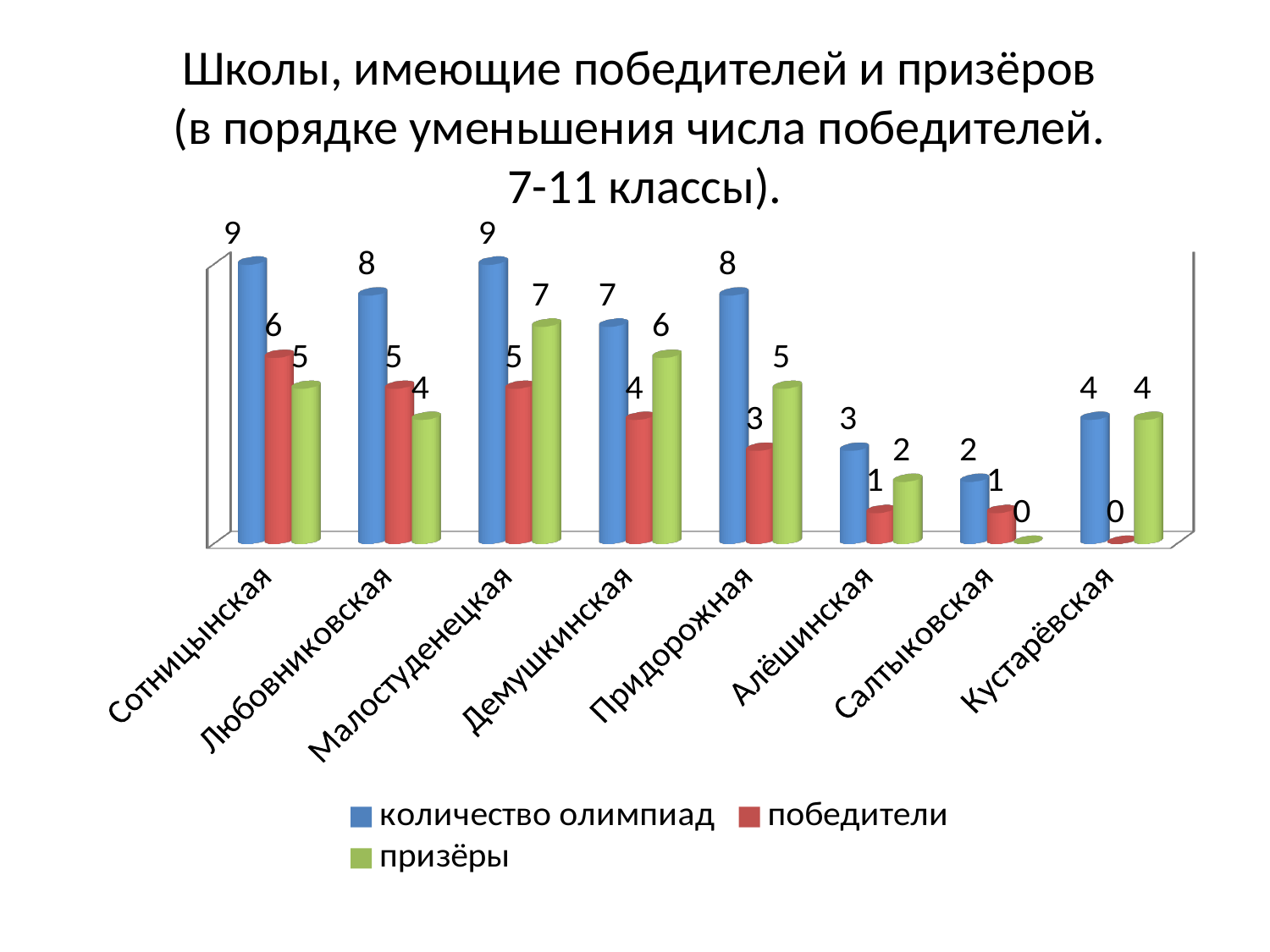
What is the difference between количество олимпиад and победители for Придорожная? 5 What is the value of призёры for Малостуденецкая? 7 What is the value of победители for Сотницынская? 6 Which is larger for Демушкинская: победители or призёры? призёры Which school has the highest value for победители? Сотницынская How many schools are shown on the x axis? 8 Which school has the lowest value for количество олимпиад? Салтыковская How many series does the legend list? 3 What is the value of количество олимпиад for Придорожная? 8 Which colour represents призёры in the legend? green What is the value of победители for Кустарёвская? 0 What kind of chart is shown on the slide? bar chart